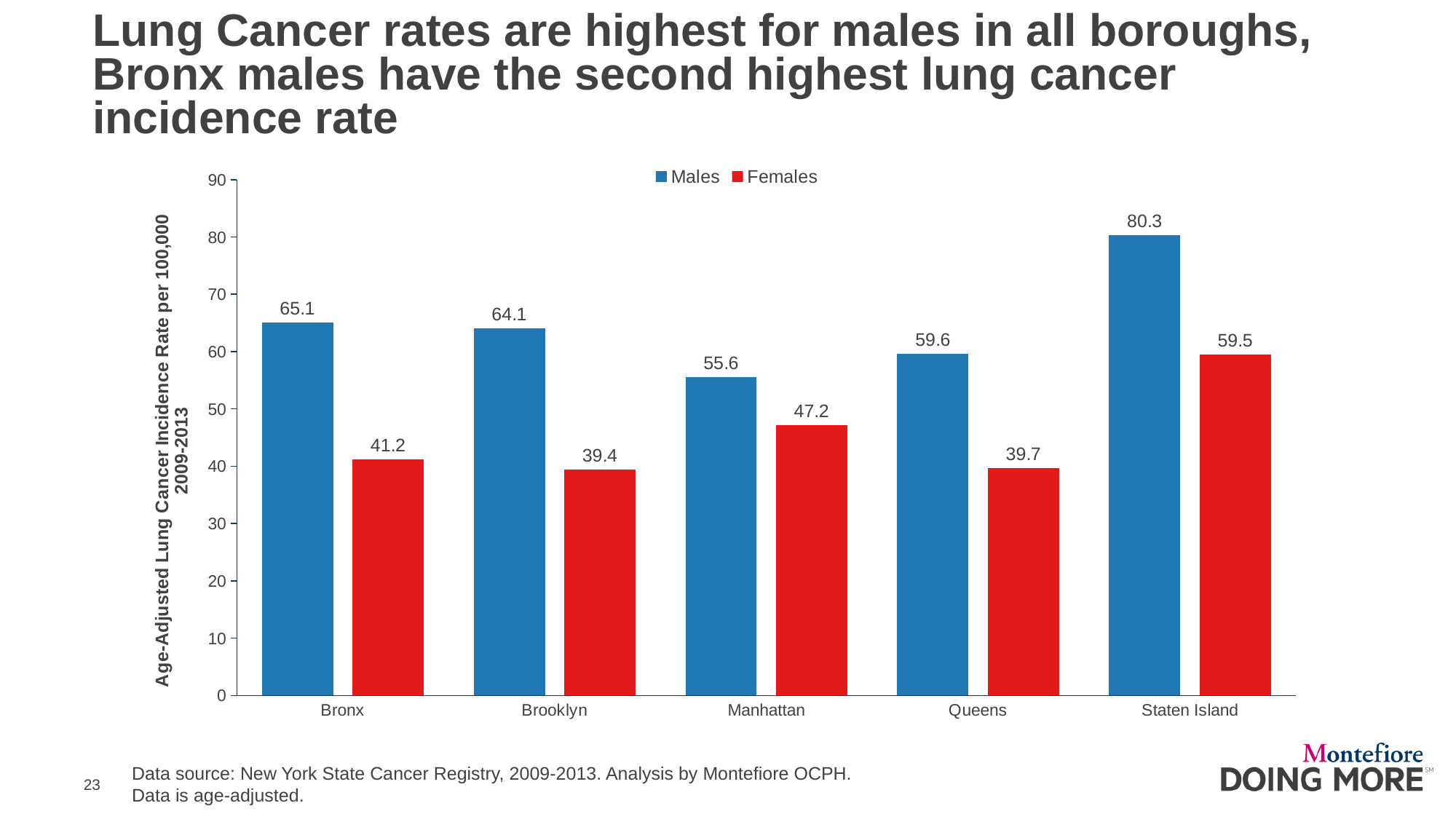
Is the male lung cancer incidence rate in Queens greater or less than 50? greater Which colour represents Females in the chart? Red What is the difference between the male and female lung cancer incidence rates in Staten Island? 20.8 Which borough has the highest lung cancer incidence rate for males? Staten Island How many series does the legend list? 2 Which is larger, the female rate in Staten Island or the male rate in Manhattan? Female rate in Staten Island What is the lung cancer incidence rate for females in Manhattan? 47.2 What is the difference between the male lung cancer rates in the Bronx and Brooklyn? 1.0 How many boroughs are shown on the x axis? 5 What kind of chart is shown on the slide? Bar chart Which borough has the lowest lung cancer incidence rate for females? Brooklyn What is the lung cancer incidence rate for males in the Bronx? 65.1